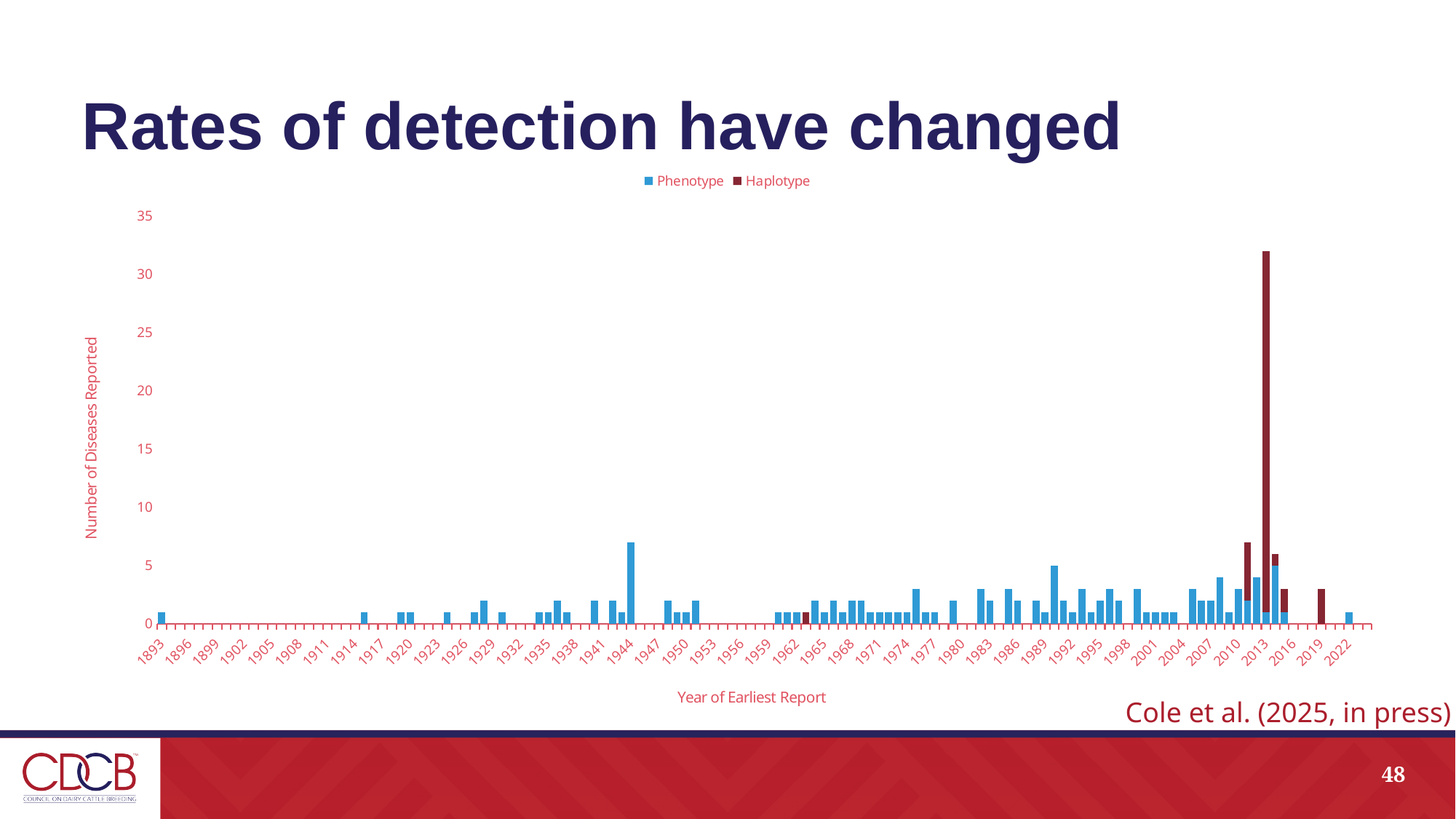
Is the Haplotype bar at 2019 greater or less than 5? less Is the Phenotype bar at 1944 greater or less than 5? greater Which is taller: the tallest Haplotype bar or the tallest Phenotype bar? the tallest Haplotype bar Is the Phenotype bar at 1893 greater or less than 5? less What is the highest value shown on the vertical axis? 35 How many series does the legend list? 2 What kind of chart is shown on the slide? bar chart What are the two series named in the legend? Phenotype and Haplotype Which series contains the tallest bar on the chart? Haplotype What is the title of the vertical axis? Number of Diseases Reported